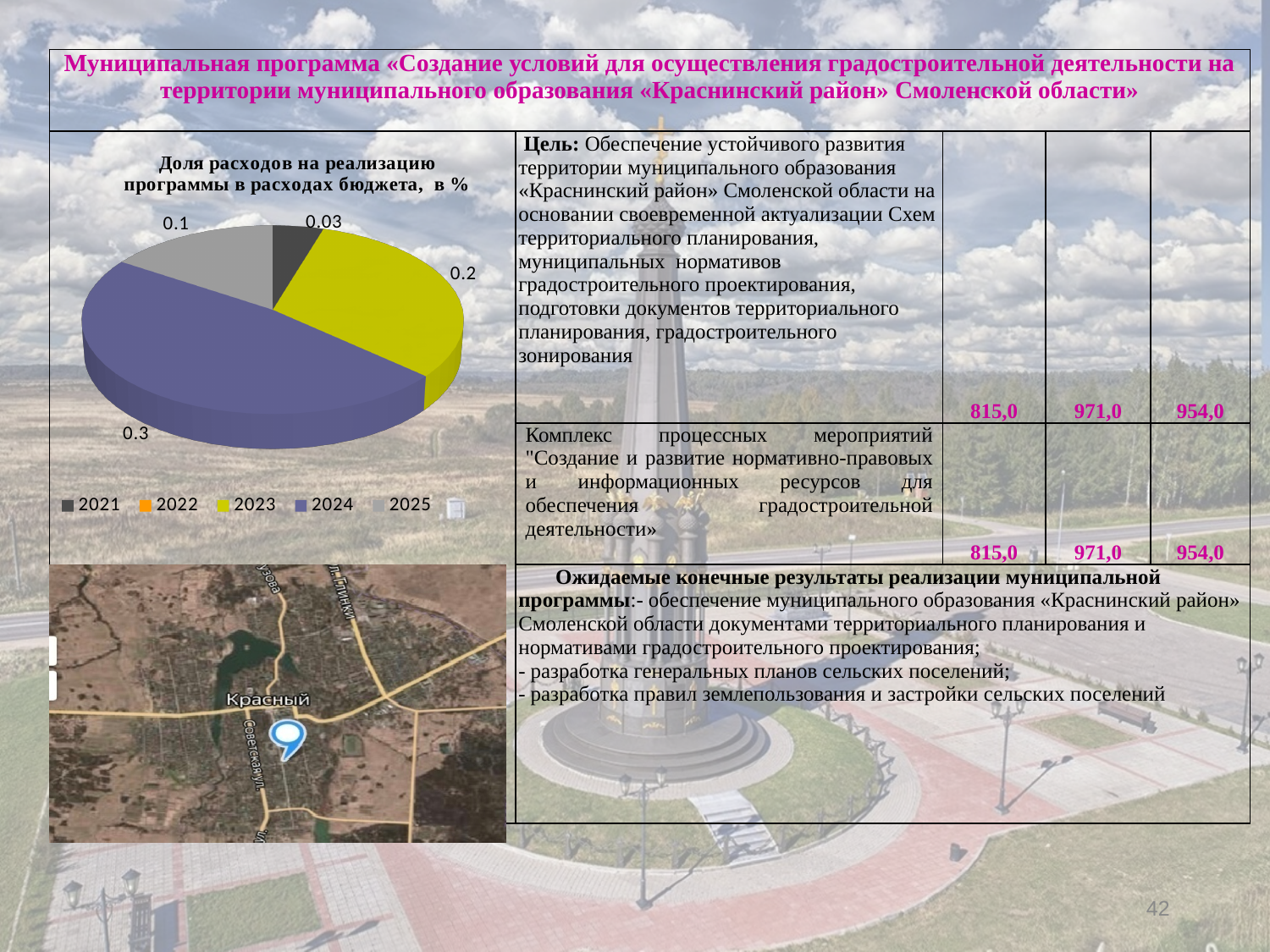
What colour is the slice for 2024 in the pie chart? purple What is the title of the pie chart? Доля расходов на реализацию программы в расходах бюджета, в % What value is shown for 2024 in the pie chart? 0.3 What is the difference between the values for 2024 and 2025 in the pie chart? 0.2 Which year has the largest slice in the pie chart? 2024 How many years are listed in the legend of the pie chart? 5 What type of chart is shown on the slide? pie chart What value is shown for 2021 in the pie chart? 0.03 Which is larger in the pie chart, the value for 2024 or the value for 2023? 2024 What is the difference between the values for 2024 and 2023 in the pie chart? 0.1 What value is shown for 2025 in the pie chart? 0.1 What value is shown for 2023 in the pie chart? 0.2